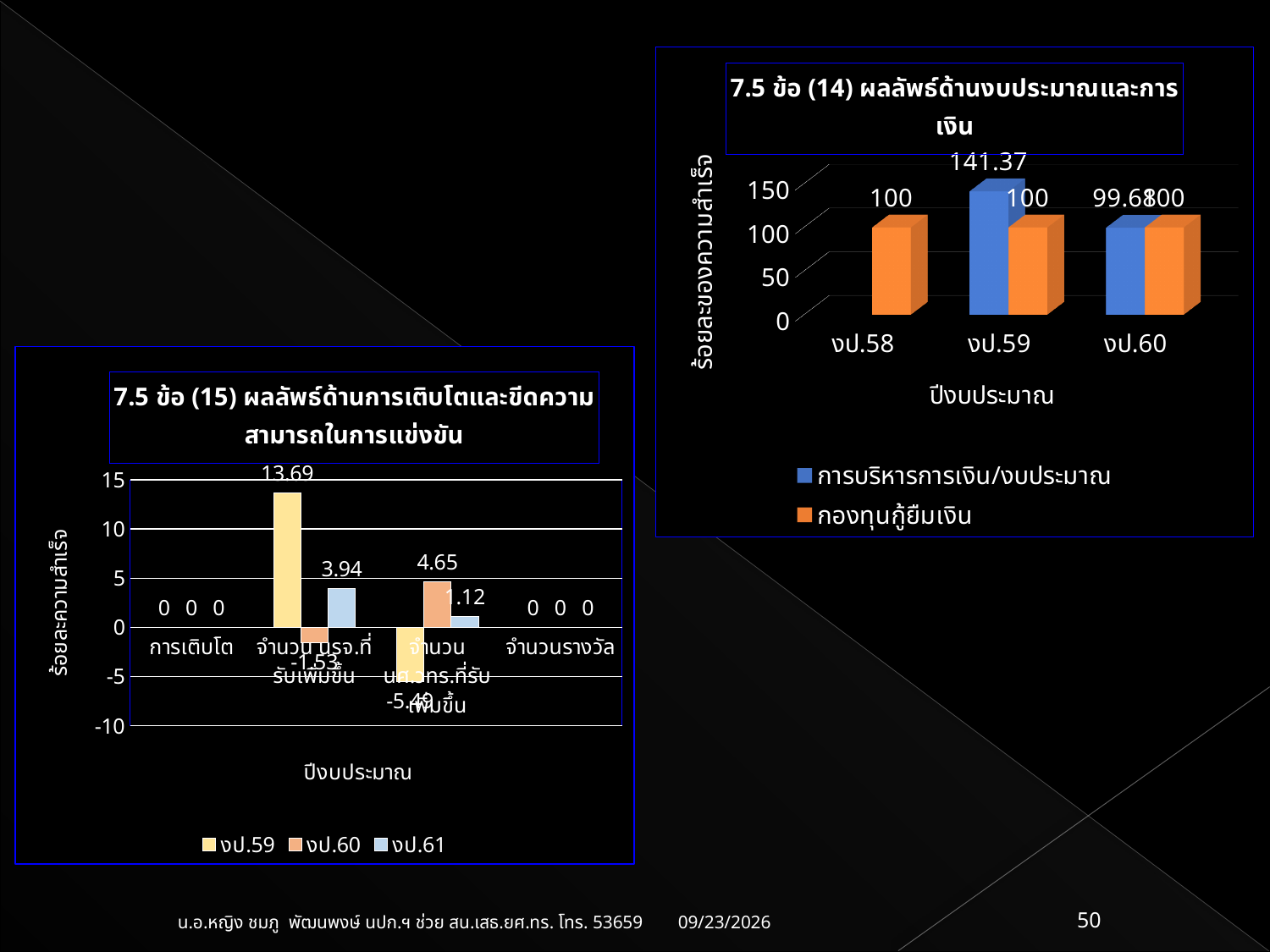
In the chart titled '7.5 ข้อ (15) ผลลัพธ์ด้านการเติบโตและขีดความสามารถในการแข่งขัน', how many categories are shown on the x axis? 4 In the chart titled '7.5 ข้อ (14) ผลลัพธ์ด้านงบประมาณและการเงิน', is the value of การบริหารการเงิน/งบประมาณ for งป.59 greater or less than 100? greater In the chart titled '7.5 ข้อ (14) ผลลัพธ์ด้านงบประมาณและการเงิน', which year has the highest value for การบริหารการเงิน/งบประมาณ? งป.59 In the chart titled '7.5 ข้อ (15) ผลลัพธ์ด้านการเติบโตและขีดความสามารถในการแข่งขัน', what is the value of งป.59 for จำนวน นรจ.ที่รับเพิ่มขึ้น? 13.69 In the chart titled '7.5 ข้อ (15) ผลลัพธ์ด้านการเติบโตและขีดความสามารถในการแข่งขัน', what is the difference between the งป.59 value for จำนวน นรจ.ที่รับเพิ่มขึ้น and the งป.61 value for the same category? 9.75 In the chart titled '7.5 ข้อ (14) ผลลัพธ์ด้านงบประมาณและการเงิน', what is the value of กองทุนกู้ยืมเงิน for งป.58? 100 What type of chart is '7.5 ข้อ (15) ผลลัพธ์ด้านการเติบโตและขีดความสามารถในการแข่งขัน'? Bar chart In the chart titled '7.5 ข้อ (15) ผลลัพธ์ด้านการเติบโตและขีดความสามารถในการแข่งขัน', what is the value of งป.61 for จำนวน นรจ.ที่รับเพิ่มขึ้น? 3.94 In the chart titled '7.5 ข้อ (14) ผลลัพธ์ด้านงบประมาณและการเงิน', how many series does the legend list? 2 In the chart titled '7.5 ข้อ (14) ผลลัพธ์ด้านงบประมาณและการเงิน', what is the value of การบริหารการเงิน/งบประมาณ for งป.59? 141.37